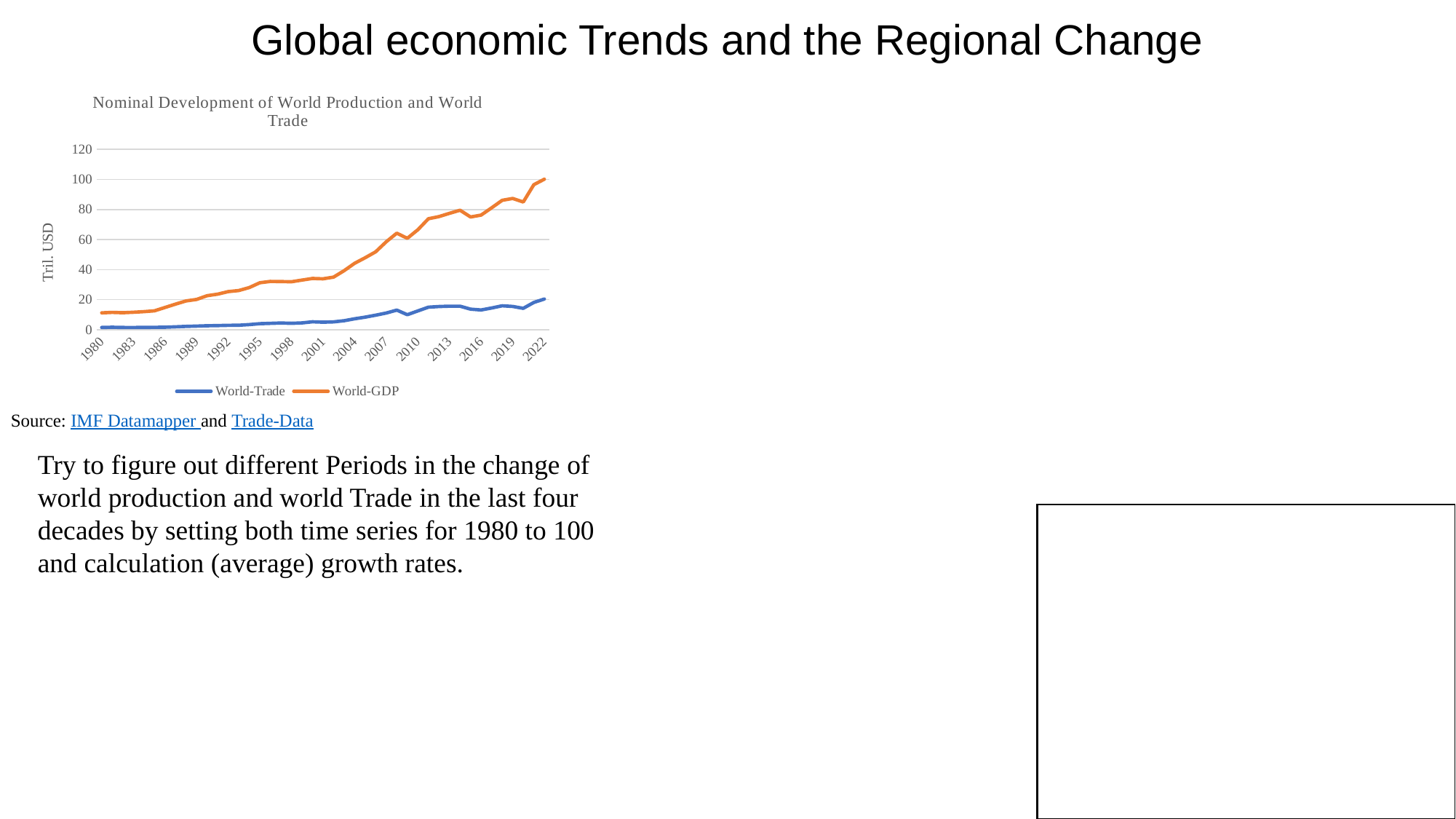
Is the value for World-Trade in 2022 greater or less than 40? less Is the value for World-GDP in 1980 greater or less than 20? less How many series does the legend of the chart list? 2 Does the World-GDP line generally rise or fall from 1980 to 2022? rise What kind of chart is shown on the slide? line chart In 2022, which series has the larger value, World-Trade or World-GDP? World-GDP In which year does the World-GDP series reach its highest value? 2022 Does the World-Trade line generally rise or fall from 1980 to 2022? rise Is the value for World-GDP in 2013 greater or less than 60? greater What is the label on the vertical axis of the chart? Tril. USD What is the title of the chart? Nominal Development of World Production and World Trade